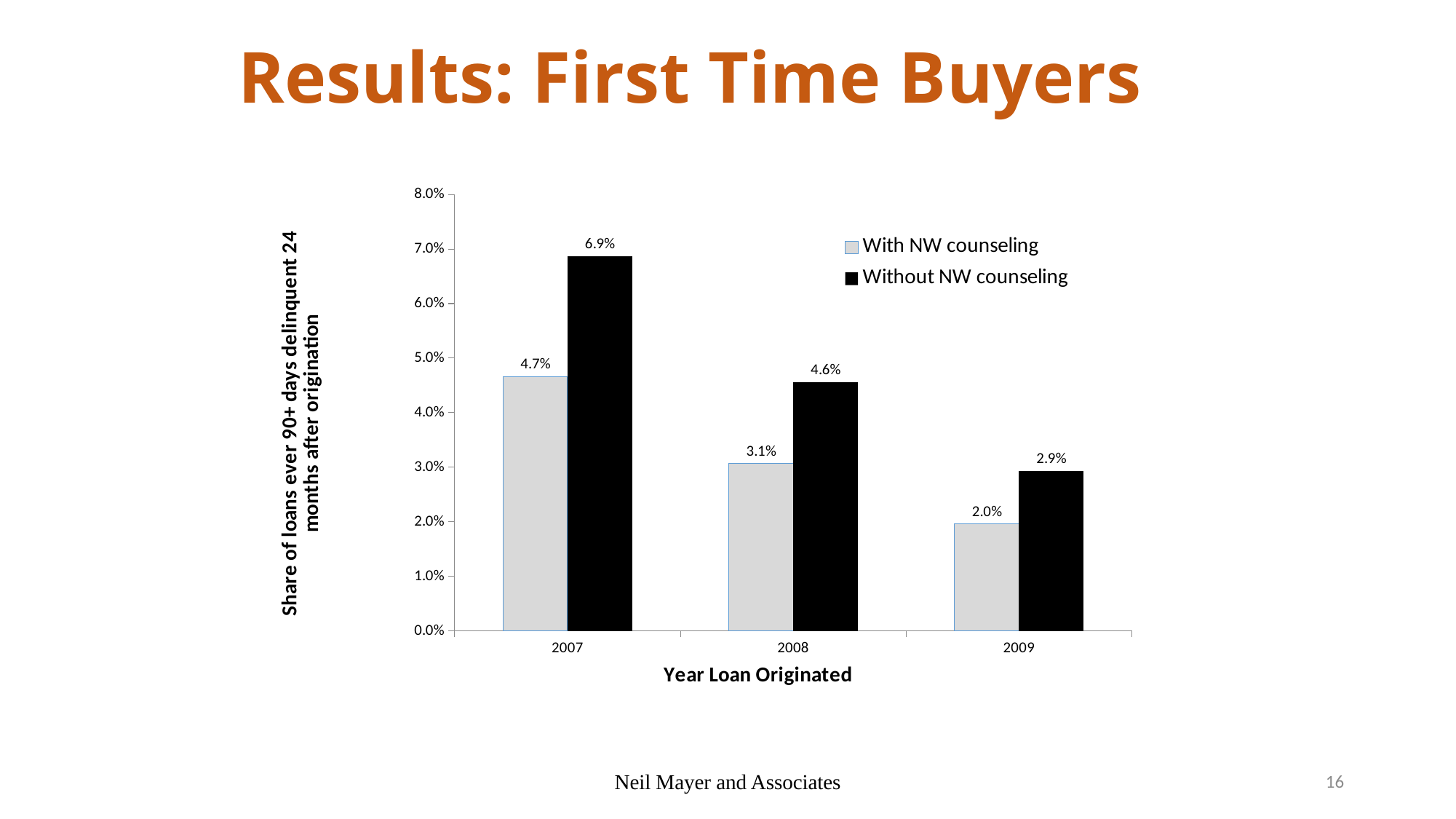
What kind of chart is shown on the slide? Bar chart How many series does the legend list? 2 What is the value for 'Without NW counseling' in 2008? 4.6% Which is larger in 2008: 'With NW counseling' or 'Without NW counseling'? Without NW counseling Is the value for 'Without NW counseling' in 2009 greater or less than 3.0%? less What is the value for 'With NW counseling' in 2007? 4.7% Which year has the highest value for 'Without NW counseling'? 2007 Which year has the lowest value for 'With NW counseling'? 2009 What is the value for 'With NW counseling' in 2009? 2.0% What is the difference between 'Without NW counseling' and 'With NW counseling' in 2007? 2.2% How many years are shown on the x axis? 3 Do the values for 'With NW counseling' rise or fall from 2007 to 2009? Fall